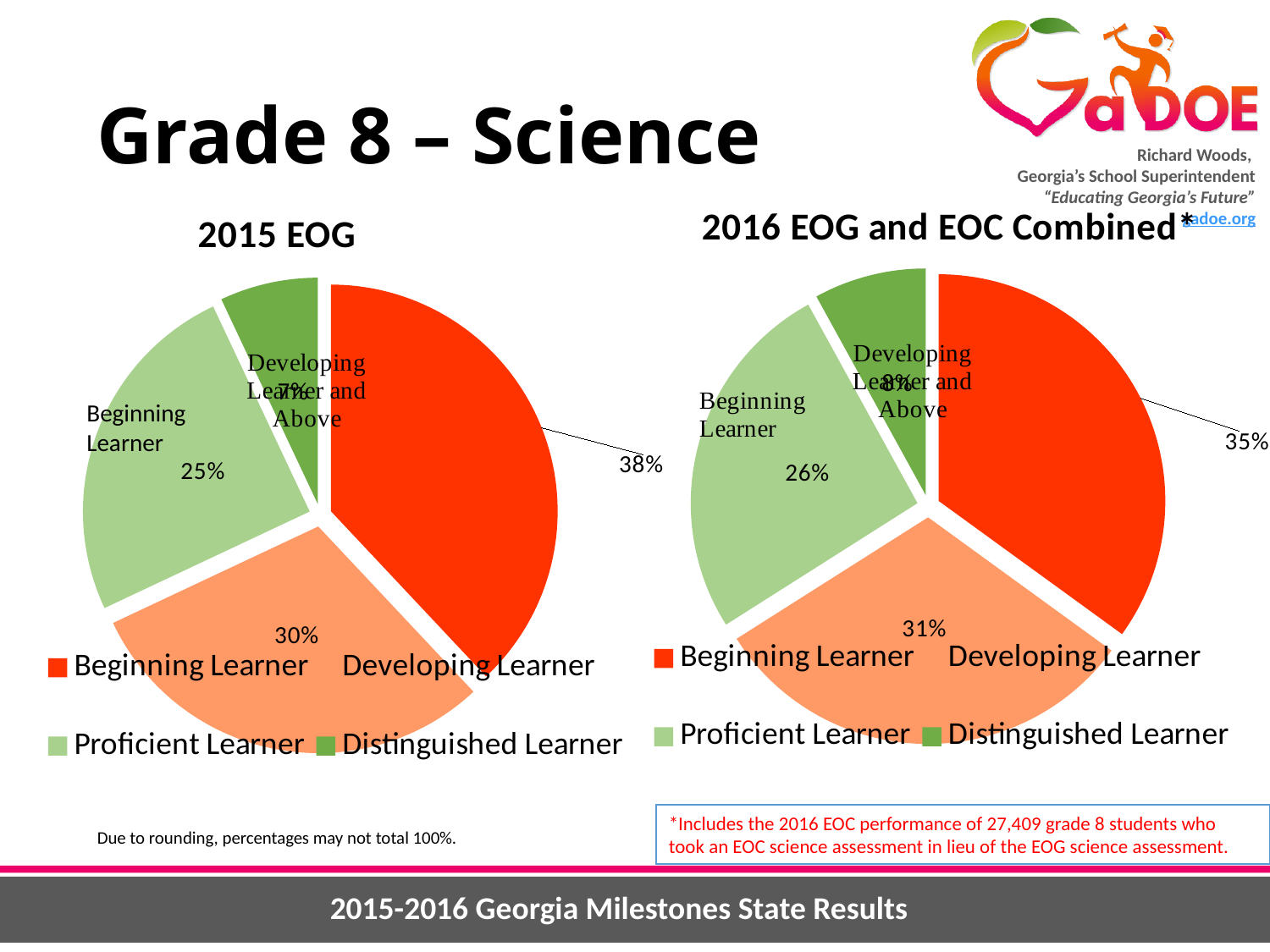
In the 2015 EOG chart, which achievement level has the largest share? Beginning Learner In the 2016 EOG and EOC Combined chart, which is larger: the Developing Learner share or the Proficient Learner share? Developing Learner In the 2015 EOG chart, what percentage of students were Beginning Learners? 38% In the 2016 EOG and EOC Combined chart, what percentage of students were Beginning Learners? 35% In the 2016 EOG and EOC Combined chart, which achievement level has the smallest share? Distinguished Learner In the 2016 EOG and EOC Combined chart, what percentage of students were Proficient Learners? 26% In the 2015 EOG chart, what percentage of students were Proficient Learners? 25% How many achievement levels does the legend of the 2016 EOG and EOC Combined chart list? 4 What type of chart is used for the 2015 EOG data? Pie chart In the 2016 EOG and EOC Combined chart, what percentage of students were Developing Learners? 31% What is the difference between the Beginning Learner share in the 2015 EOG chart and in the 2016 EOG and EOC Combined chart? 3 percentage points In the 2015 EOG chart, what percentage of students were Developing Learners? 30%